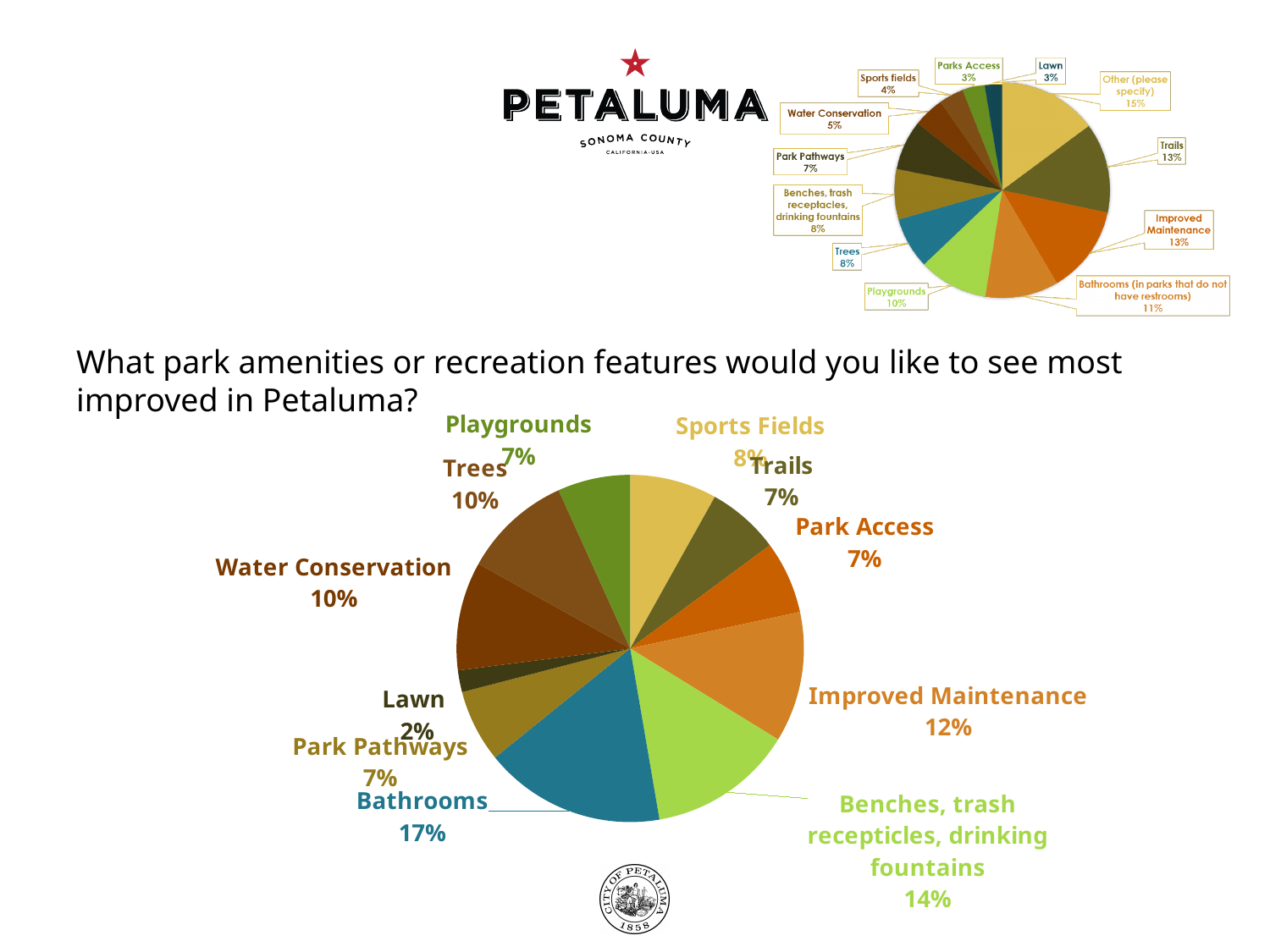
In the large pie chart at the bottom of the slide, which category has the smallest share? Lawn In the large pie chart at the bottom of the slide, what is the difference in percentage points between Bathrooms and Benches, trash recepticles, drinking fountains? 3 In the large pie chart at the bottom of the slide, what percentage is shown for Improved Maintenance? 12% In the large pie chart at the bottom of the slide, which is larger: Water Conservation or Park Access? Water Conservation In the large pie chart at the bottom of the slide, which category has the largest share? Bathrooms In the small pie chart at the top right of the slide, what percentage is shown for Water Conservation? 5% What type of chart is the large chart at the bottom of the slide? Pie chart What question is written above the large pie chart at the bottom of the slide? What park amenities or recreation features would you like to see most improved in Petaluma? In the small pie chart at the top right of the slide, what percentage is shown for Trails? 13% In the large pie chart at the bottom of the slide, what percentage is shown for Bathrooms? 17% In the small pie chart at the top right of the slide, which category has the largest share? Other (please specify) How many categories are labelled in the large pie chart at the bottom of the slide? 11